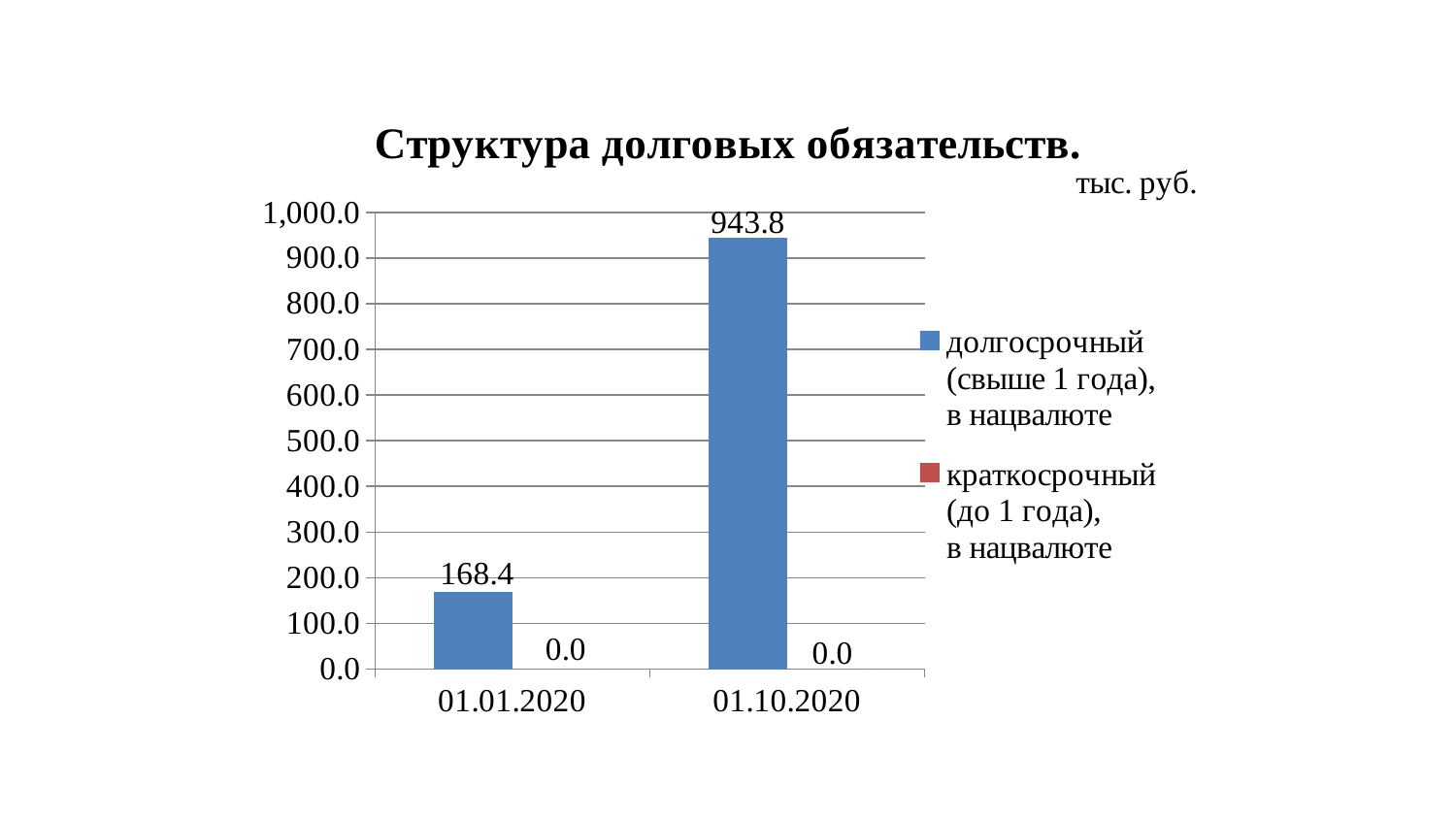
What kind of chart is shown? bar chart What is the title of the chart? Структура долговых обязательств. What is the value of краткосрочный (до 1 года), в нацвалюте for 01.01.2020? 0.0 What is the value of долгосрочный (свыше 1 года), в нацвалюте for 01.01.2020? 168.4 What is the value of долгосрочный (свыше 1 года), в нацвалюте for 01.10.2020? 943.8 What is the value of краткосрочный (до 1 года), в нацвалюте for 01.10.2020? 0.0 Which is larger: the долгосрочный value for 01.01.2020 or for 01.10.2020? 01.10.2020 How many series does the legend list? 2 Is the долгосрочный value for 01.10.2020 greater or less than 900.0? greater What is the difference between the долгосрочный values for 01.10.2020 and 01.01.2020? 775.4 On which date is the долгосрочный (свыше 1 года) value highest? 01.10.2020 How many dates are shown on the x axis? 2